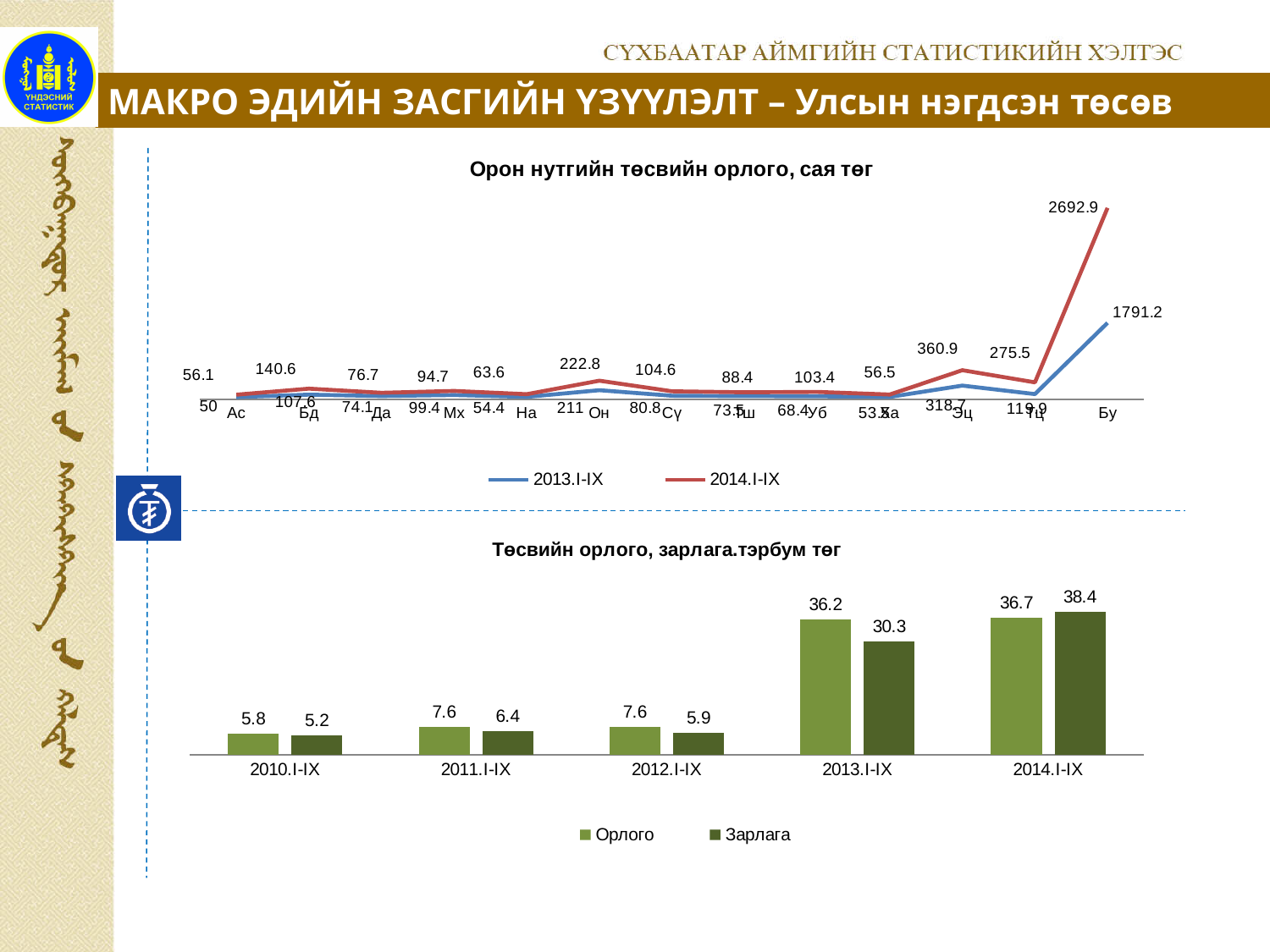
In the bottom chart 'Төсвийн орлого, зарлага.тэрбум төг', how many periods are shown on the x axis? 5 In the bottom chart 'Төсвийн орлого, зарлага.тэрбум төг', is Орлого or Зарлага larger for 2014.I-IX? Зарлага In the bottom chart 'Төсвийн орлого, зарлага.тэрбум төг', what is the difference between Орлого and Зарлага for 2012.I-IX? 1.7 In the top chart 'Орон нутгийн төсвийн орлого, сая төг', what is the 2014.I-IX value for Бу? 2692.9 In the top chart 'Орон нутгийн төсвийн орлого, сая төг', what is the difference between the 2014.I-IX and 2013.I-IX values for Бу? 901.7 In the bottom chart 'Төсвийн орлого, зарлага.тэрбум төг', which period has the highest Зарлага value? 2014.I-IX What kind of chart is the bottom chart 'Төсвийн орлого, зарлага.тэрбум төг'? Bar chart In the top chart 'Орон нутгийн төсвийн орлого, сая төг', what is the 2013.I-IX value for Он? 211 How many series does the legend of the top chart 'Орон нутгийн төсвийн орлого, сая төг' list? 2 In the bottom chart 'Төсвийн орлого, зарлага.тэрбум төг', which period has the lowest Орлого value? 2010.I-IX In the bottom chart 'Төсвийн орлого, зарлага.тэрбум төг', what is the Орлого value for 2014.I-IX? 36.7 In the bottom chart 'Төсвийн орлого, зарлага.тэрбум төг', what is the Зарлага value for 2013.I-IX? 30.3